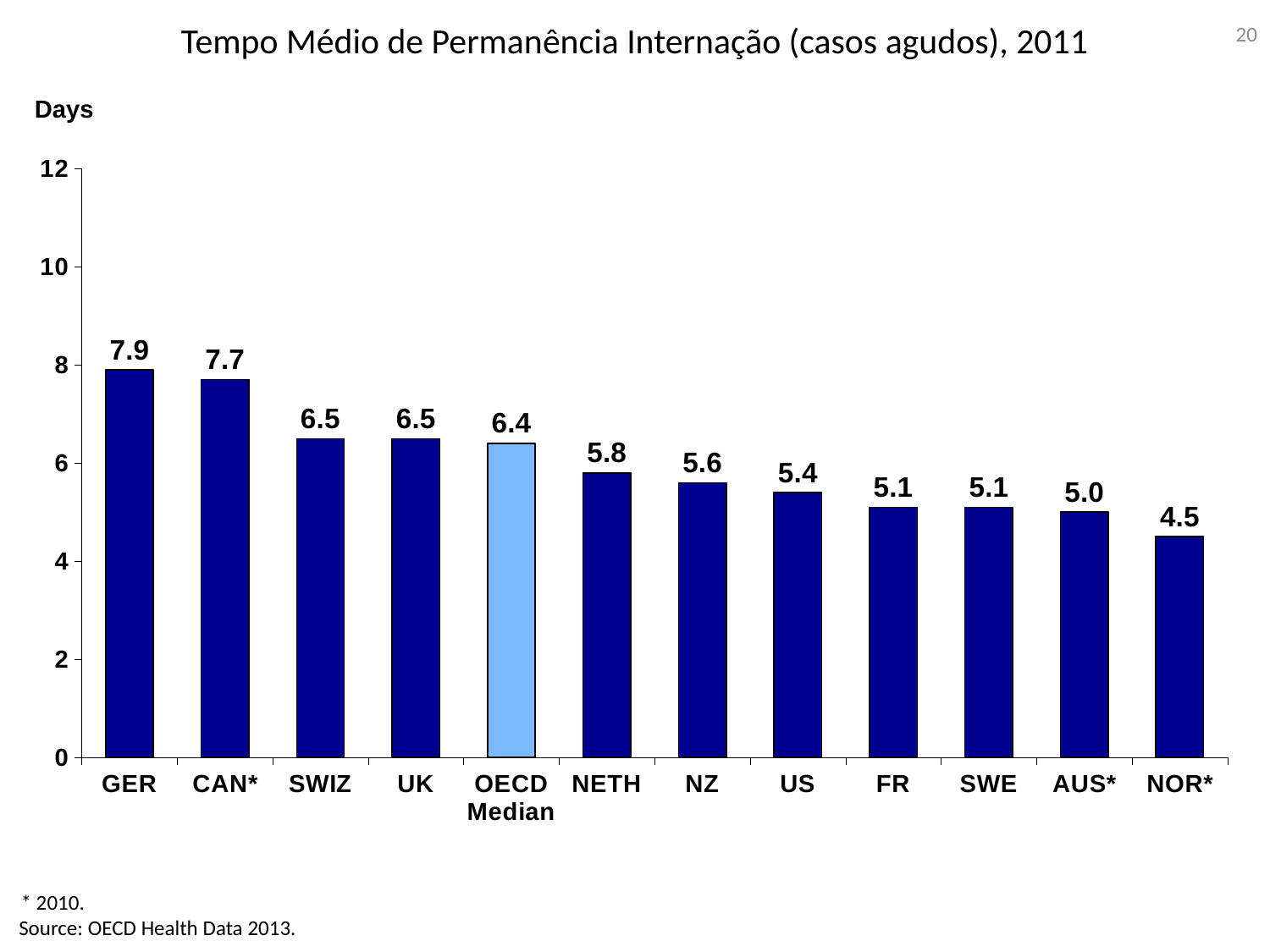
What is the difference between the values for GER and NOR*? 3.4 Which category has the lowest value? NOR* Which is larger, the value for NETH or the value for FR? NETH Which category has the highest value? GER Is the value for NZ greater or less than 6? less What is the value shown for NOR*? 4.5 What is the average length of stay for GER? 7.9 What is the value shown for the OECD Median? 6.4 How many categories are shown on the x axis? 12 What unit is shown on the y axis label? Days What is the difference between the values for CAN* and US? 2.3 What kind of chart is shown on the slide? bar chart